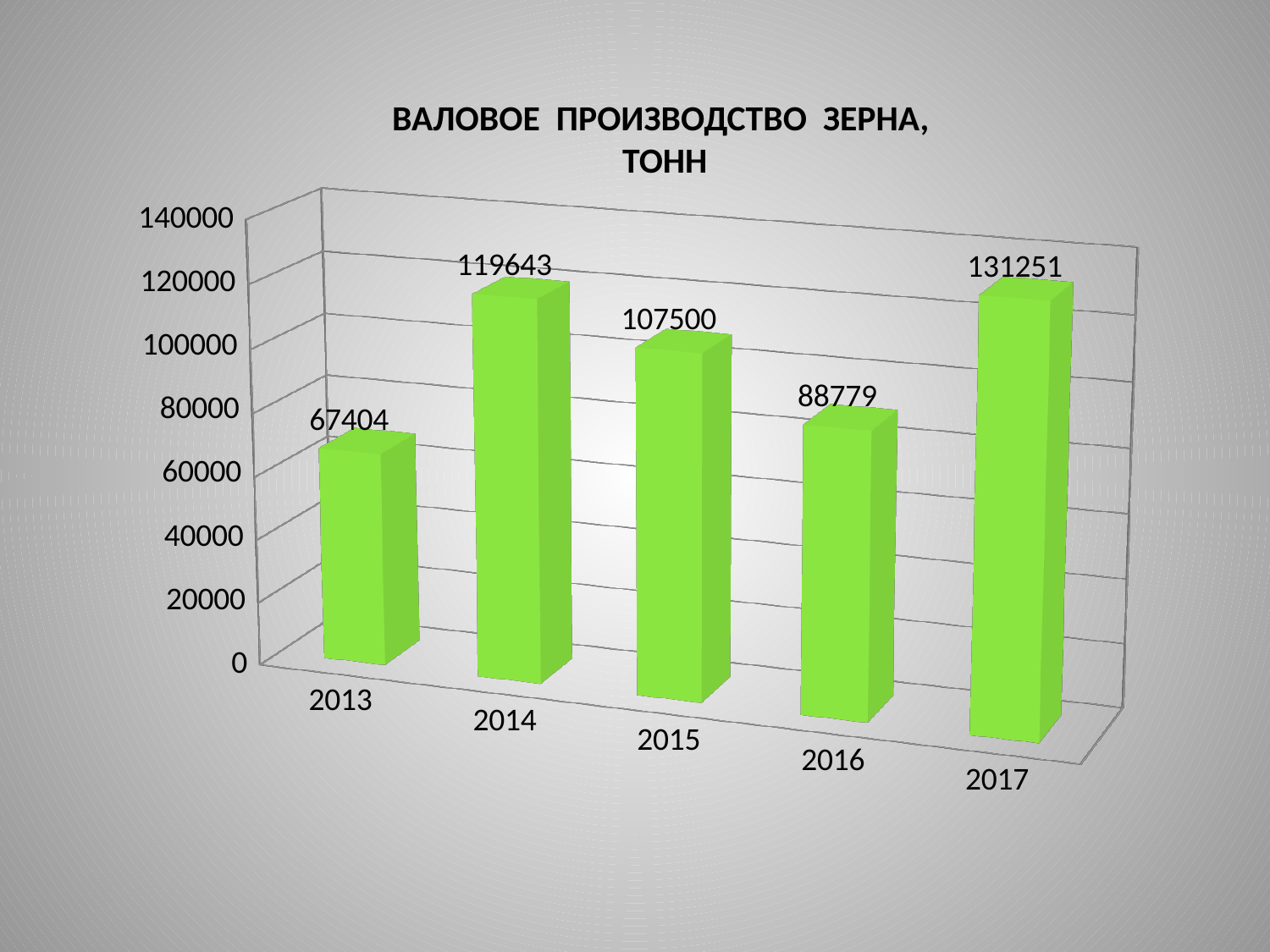
What is the value shown for 2013? 67404 What is the difference between the values for 2017 and 2013? 63847 Which is larger, the value for 2015 or the value for 2016? 2015 What kind of chart is shown on the slide? bar chart What is the title of the chart? ВАЛОВОЕ ПРОИЗВОДСТВО ЗЕРНА, ТОНН Which year has the highest gross grain production? 2017 What is the gross grain production value for 2014? 119643 Is the value for 2017 greater or less than 120000? greater What is the value shown for 2016? 88779 How many years are shown on the chart? 5 What is the difference between the values for 2014 and 2015? 12143 Which year has the lowest gross grain production? 2013